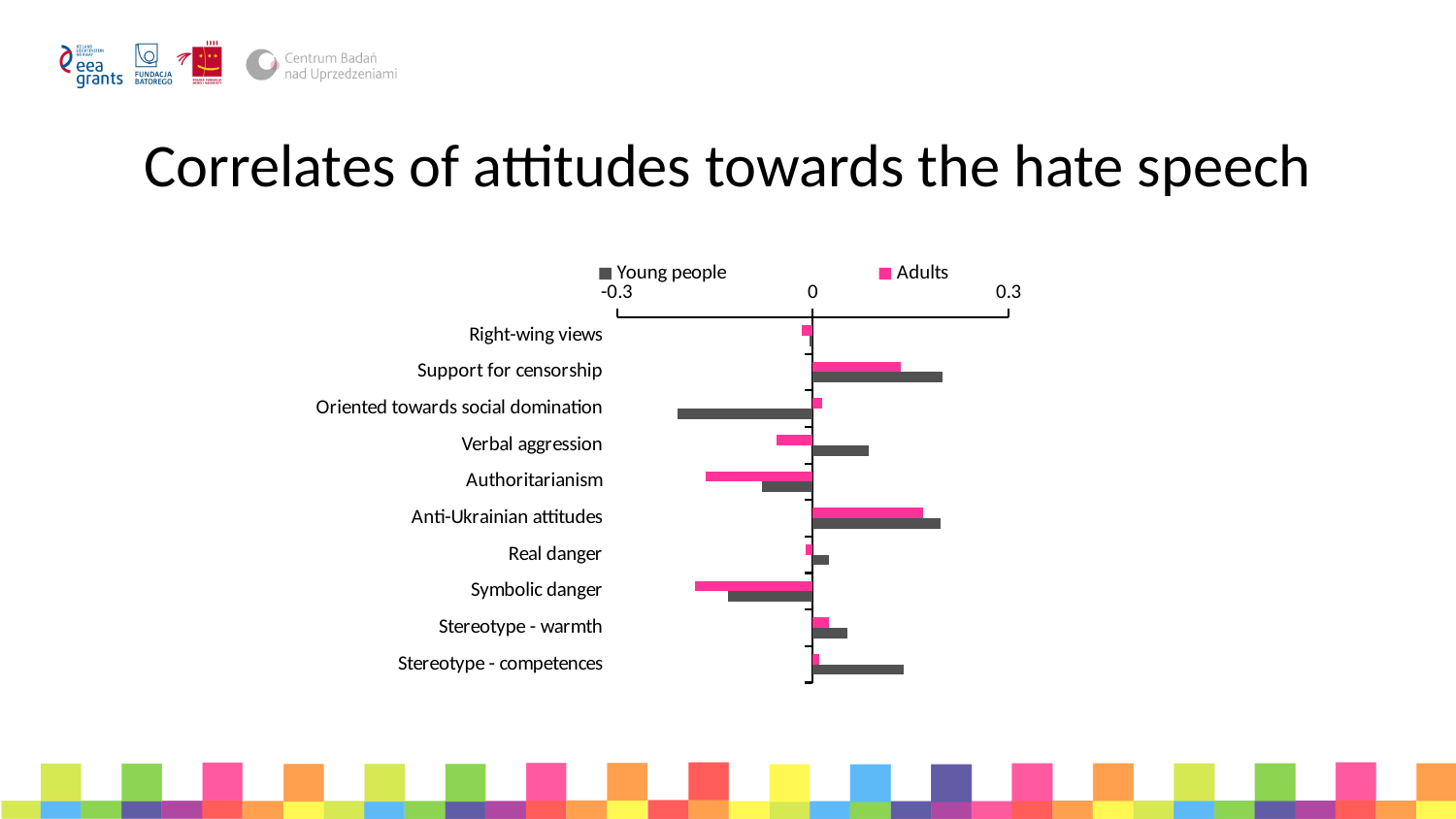
For Verbal aggression, which series has the larger value, Young people or Adults? Young people Is the Adults value for Anti-Ukrainian attitudes greater or less than 0? greater What kind of chart is shown on the slide? bar chart Which category has the highest value for Adults? Anti-Ukrainian attitudes How many categories are plotted on the chart? 10 What is the title of the slide's chart? Correlates of attitudes towards the hate speech Which category has the lowest value for Young people? Oriented towards social domination Is the Young people value for Oriented towards social domination greater or less than 0? less Is the Adults value for Symbolic danger greater or less than 0? less How many series does the legend list? 2 Which colour represents the Adults series? pink